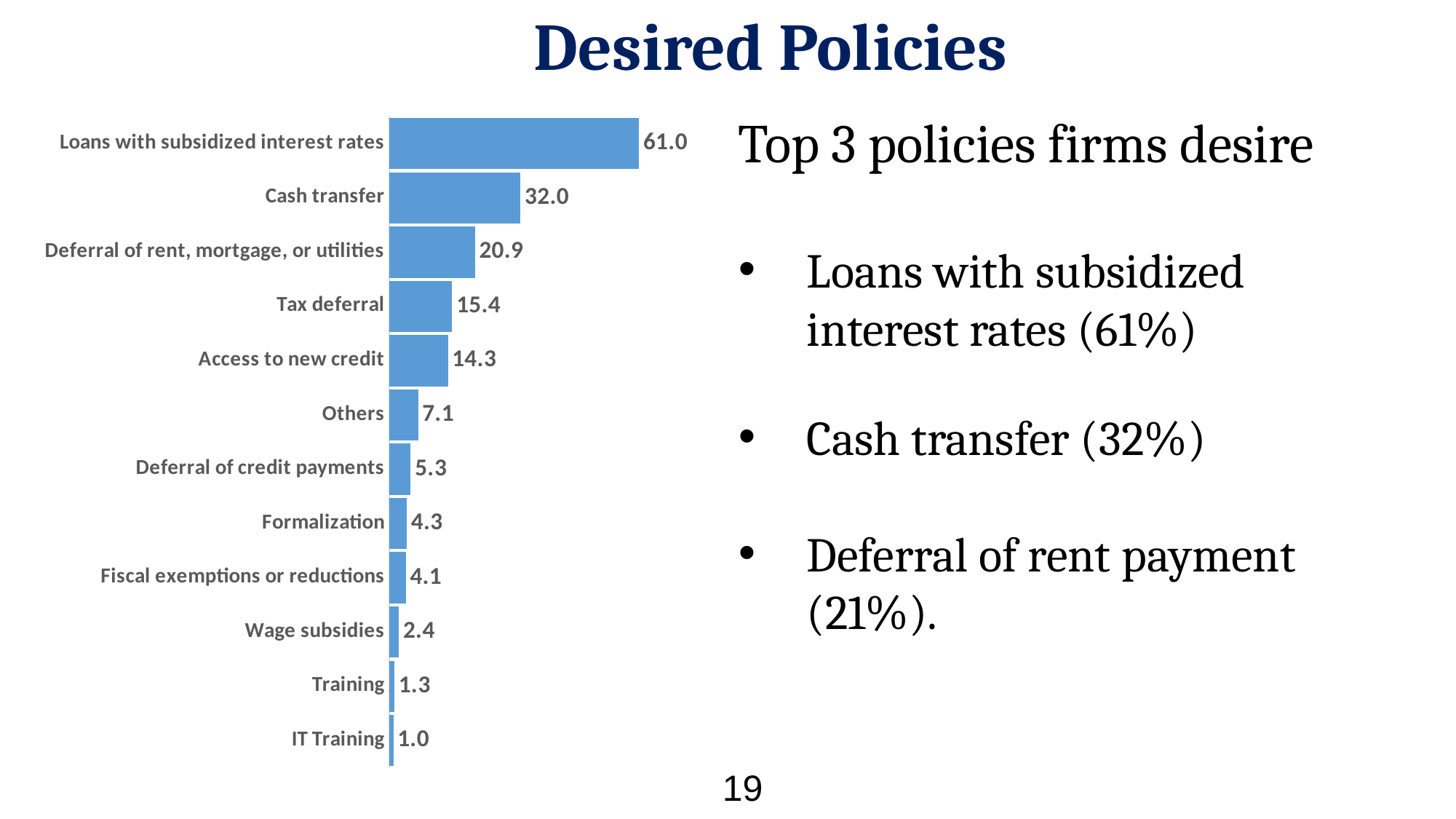
What is the value for Wage subsidies? 2.4 Which category has the highest value? Loans with subsidized interest rates Which is larger, the value for Others or the value for Deferral of credit payments? Others What is the value for Cash transfer? 32.0 Which category has the lowest value? IT Training What is the value for Access to new credit? 14.3 Which is larger, the value for Deferral of rent, mortgage, or utilities or the value for Tax deferral? Deferral of rent, mortgage, or utilities What is the difference between the values for Loans with subsidized interest rates and Cash transfer? 29.0 What kind of chart is shown on the slide? Bar chart What is the value for Formalization? 4.3 How many categories are shown in the chart? 12 What is the difference between the values for Tax deferral and Access to new credit? 1.1